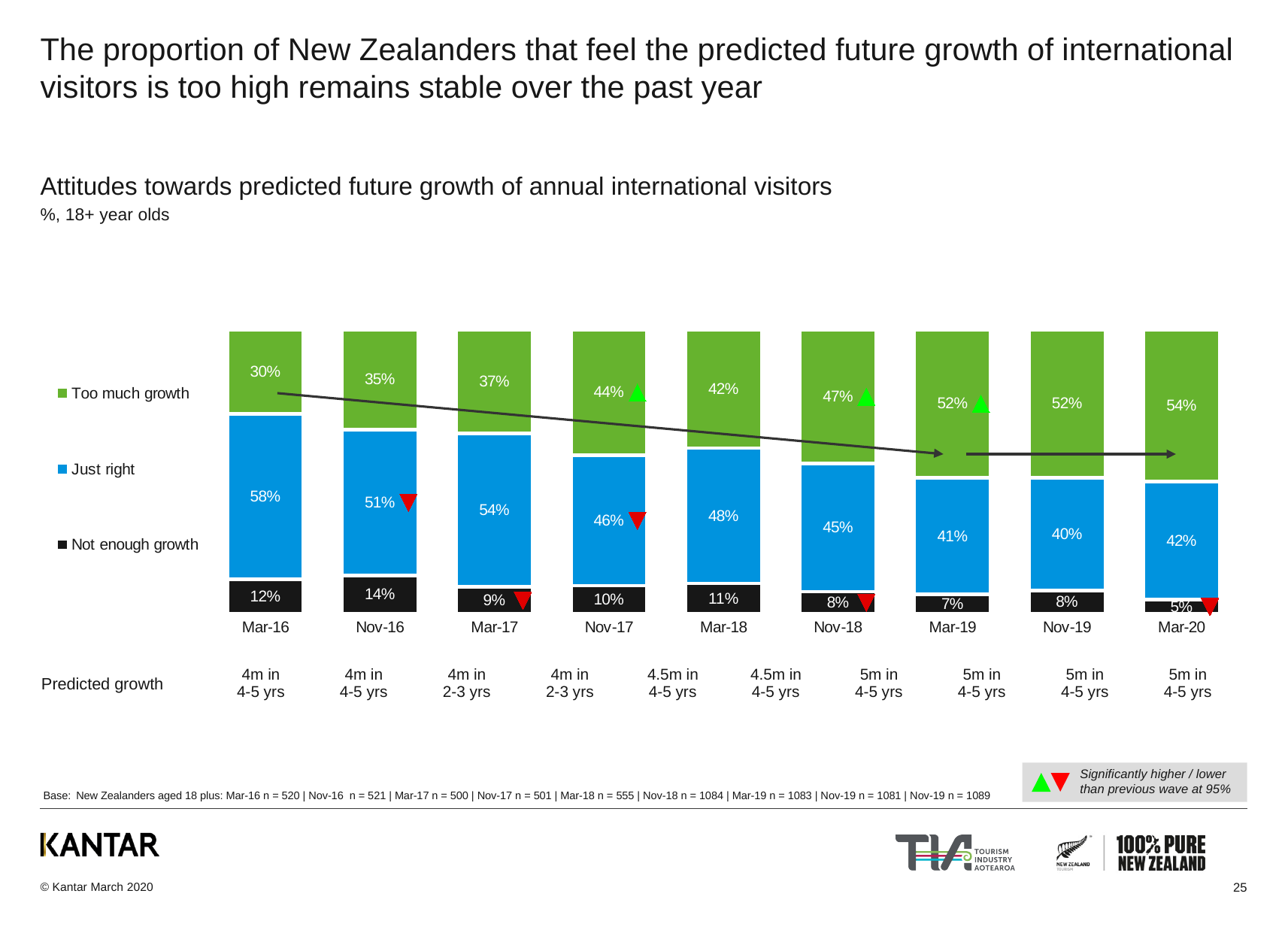
In which period was the 'Too much growth' share lowest? Mar-16 What type of chart is shown on the slide? Stacked bar chart Does the 'Too much growth' share generally rise or fall from Mar-16 to Mar-20? Rise In which period was the 'Not enough growth' share lowest? Mar-20 What percentage of respondents said 'Just right' in Mar-16? 58% How many series does the legend list? 3 How many time periods (bars) are shown on the x axis? 10 Which is larger in Nov-18: the 'Too much growth' share or the 'Just right' share? Too much growth What colour represents the 'Just right' series? Blue What percentage of respondents said 'Too much growth' in Mar-20? 54% What is the difference between the 'Too much growth' share in Mar-20 and in Mar-16? 24 percentage points What percentage of respondents said 'Not enough growth' in Nov-16? 14%